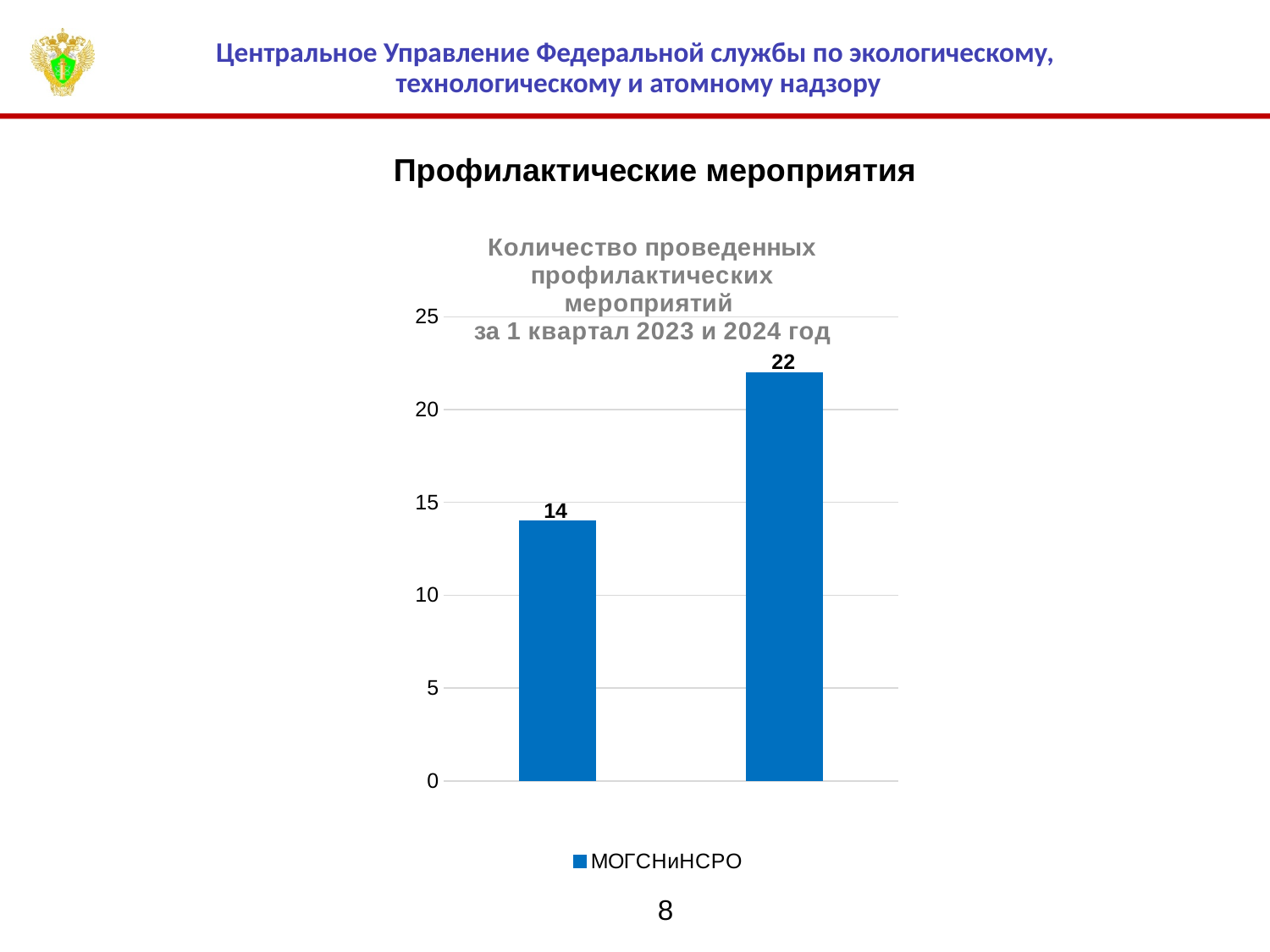
How many bars are plotted in the chart? 2 What is the highest value plotted in the chart? 22 What series name is shown in the chart legend? МОГСНиНСРО What is the lowest value plotted in the chart? 14 Which bar is taller, the left one or the right one? the right one What is the difference between the right bar and the left bar? 8 Is the value of the right bar greater or less than 20? greater How many series does the legend list? 1 Do the values rise or fall from the left bar to the right bar? rise What is the value shown on the left bar of the chart? 14 What is the value shown on the right bar of the chart? 22 What type of chart is shown on the slide? bar chart